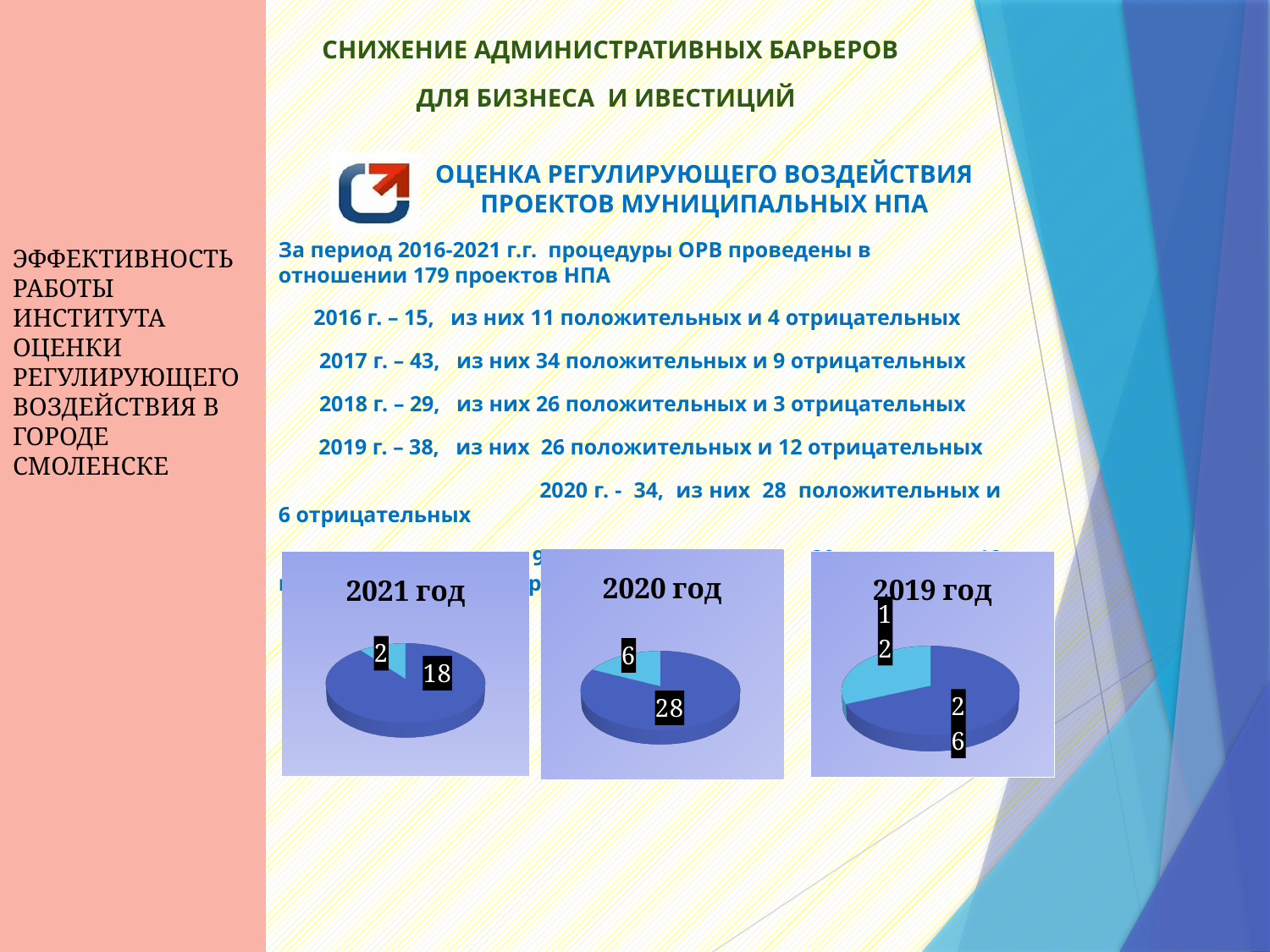
In the "2019 год" pie chart, what is the value of the larger slice? 26 In the "2020 год" pie chart, what is the difference between the larger and smaller slice values? 22 In the "2020 год" pie chart, what is the value of the smaller slice? 6 In the "2019 год" pie chart, what is the value of the smaller slice? 12 How many slices does the "2019 год" pie chart have? 2 In the "2021 год" pie chart, what is the value of the larger slice? 18 In the "2021 год" pie chart, what is the value of the smaller slice? 2 How many pie charts are shown on the slide? 3 What kind of chart is used for the "2021 год" chart? pie chart In the "2020 год" pie chart, what is the value of the larger slice? 28 In the "2021 год" pie chart, what share of the total does the slice labelled 18 represent? 90% In the "2021 год" pie chart, what is the total of the two slices? 20